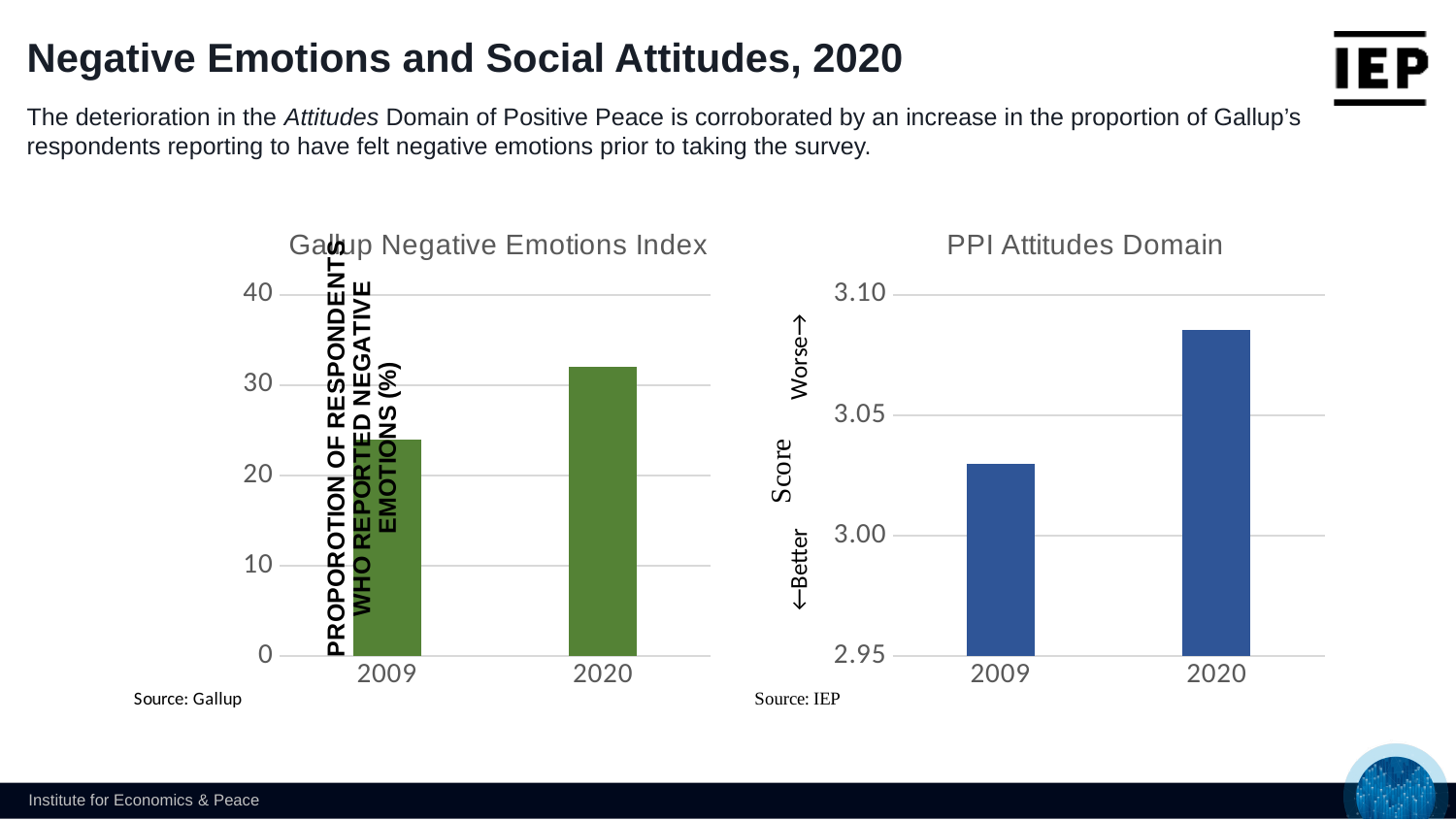
In the PPI Attitudes Domain chart, is the score for 2009 greater or less than 3.05? less In the PPI Attitudes Domain chart, which year has the higher score? 2020 In the Gallup Negative Emotions Index chart, is the value for 2009 greater or less than 30? less In the Gallup Negative Emotions Index chart, which year has the lower value? 2009 In the Gallup Negative Emotions Index chart, which year has the higher value? 2020 In the PPI Attitudes Domain chart, do the scores rise or fall from 2009 to 2020? rise What kind of chart is the PPI Attitudes Domain chart? bar chart How many categories are shown on the x axis of the Gallup Negative Emotions Index chart? 2 In the Gallup Negative Emotions Index chart, is the value for 2020 greater or less than 30? greater What is the source cited below the PPI Attitudes Domain chart? IEP